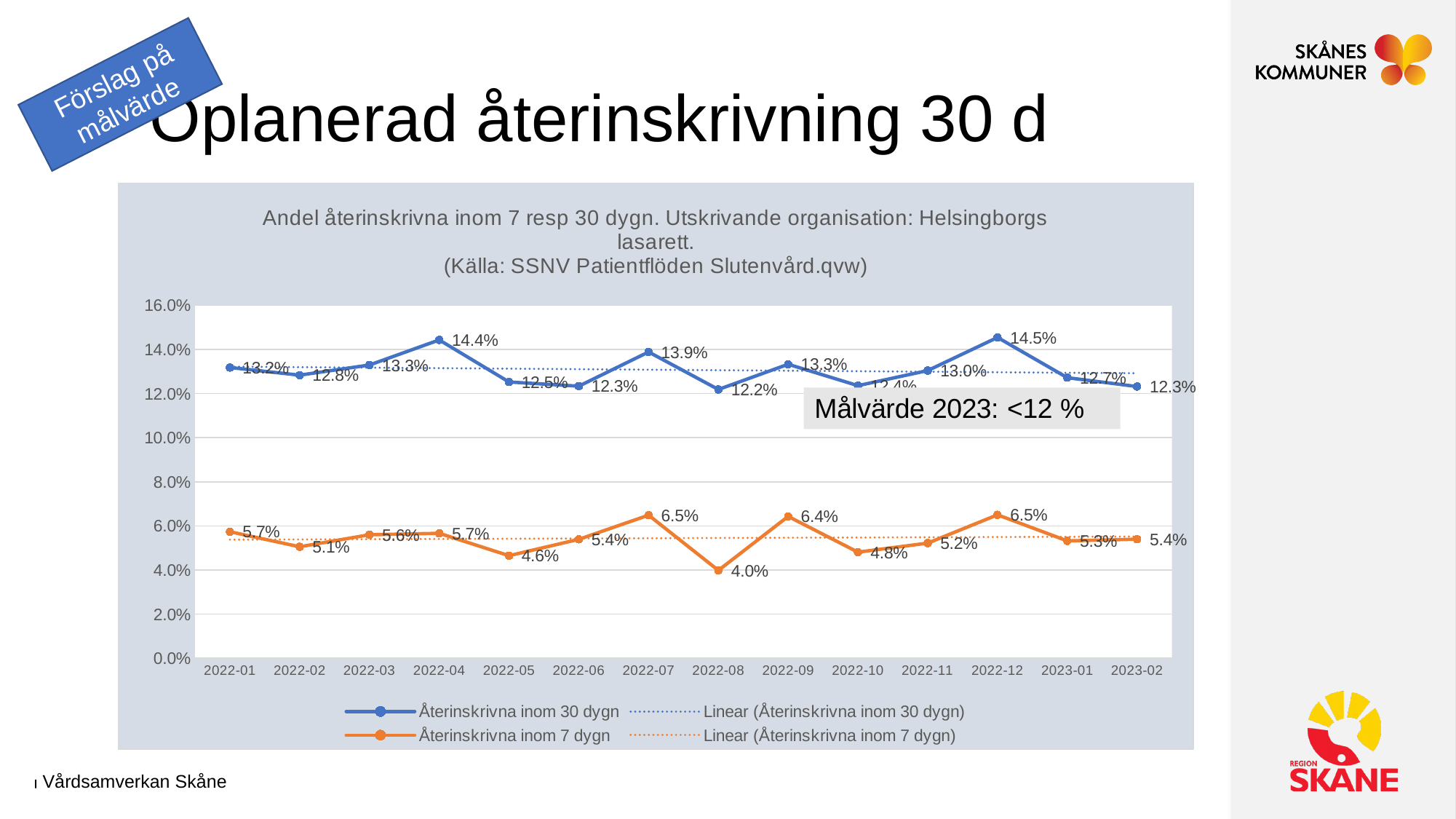
What is the difference between Återinskrivna inom 30 dygn and Återinskrivna inom 7 dygn in 2022-12? 8.0 percentage points What type of chart is shown on the slide? Line chart How many months are shown on the x axis? 14 What is the value for Återinskrivna inom 7 dygn in 2022-08? 4.0% In which month does Återinskrivna inom 7 dygn reach its lowest value? 2022-08 How many entries does the legend list? 4 What is the value for Återinskrivna inom 7 dygn in 2022-09? 6.4% Which is larger for Återinskrivna inom 30 dygn: the value in 2022-07 or the value in 2022-08? 2022-07 Is the value for Återinskrivna inom 30 dygn in 2022-12 greater or less than 14.0%? greater In which month does Återinskrivna inom 30 dygn reach its highest value? 2022-12 What is the value for Återinskrivna inom 30 dygn in 2023-02? 12.3% What is the value for Återinskrivna inom 30 dygn in 2022-04? 14.4%